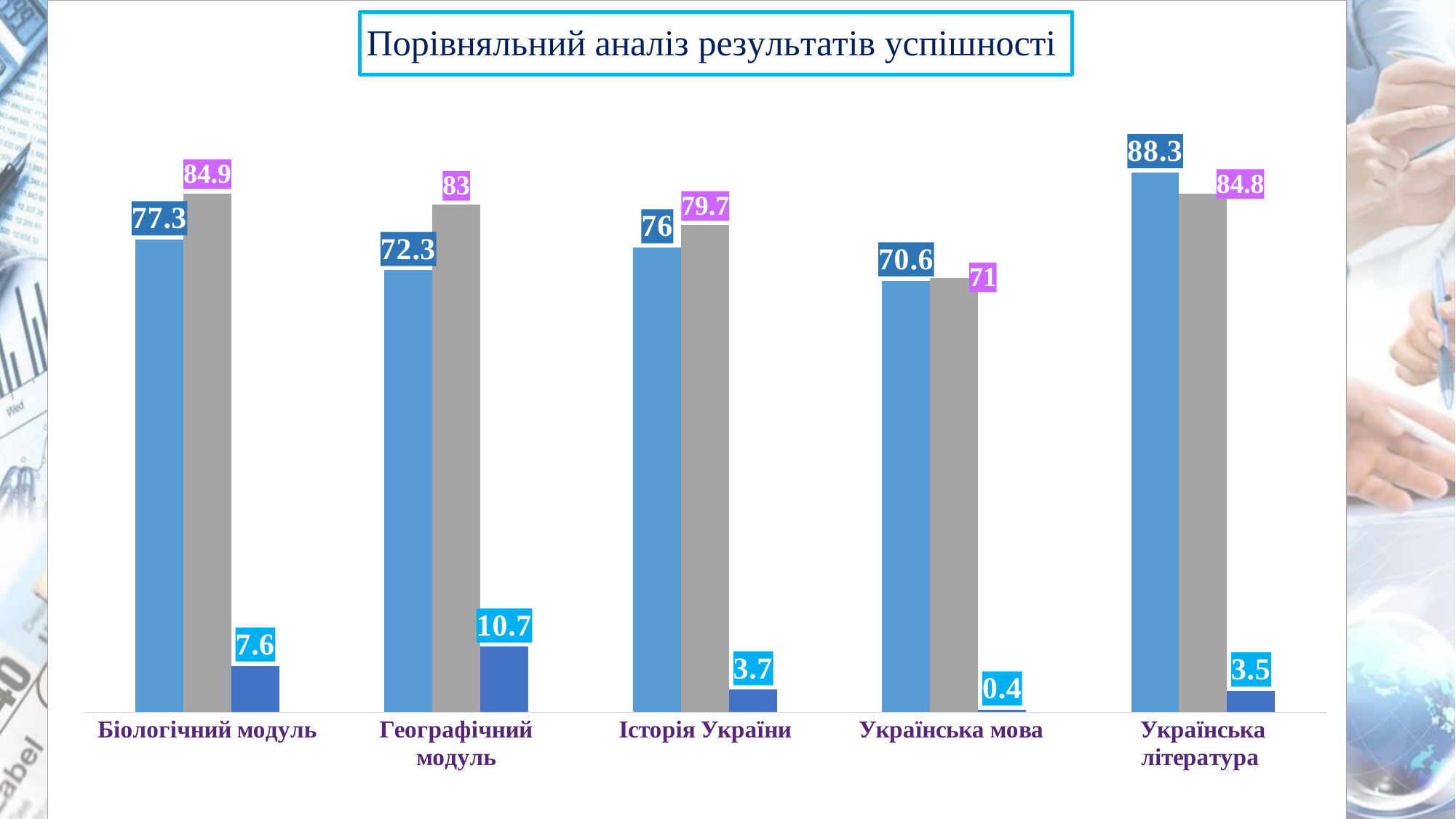
What is the value of the gray bar for Історія України? 79.7 What is the value of the gray bar for Географічний модуль? 83 How many bars are shown for each category? 3 What type of chart is shown on the slide? bar chart What is the value of the third (dark blue) bar for Українська мова? 0.4 What is the difference between the gray bar and the light blue bar for Біологічний модуль? 7.6 Which category has the lowest value for the third (dark blue) bar? Українська мова How many categories are shown on the x axis? 5 Which category has the highest value for the first (light blue) bar? Українська література Which category has the highest value for the third (dark blue) bar? Географічний модуль For Українська література, which is larger: the light blue bar or the gray bar? the light blue bar What is the value of the first (light blue) bar for Біологічний модуль? 77.3